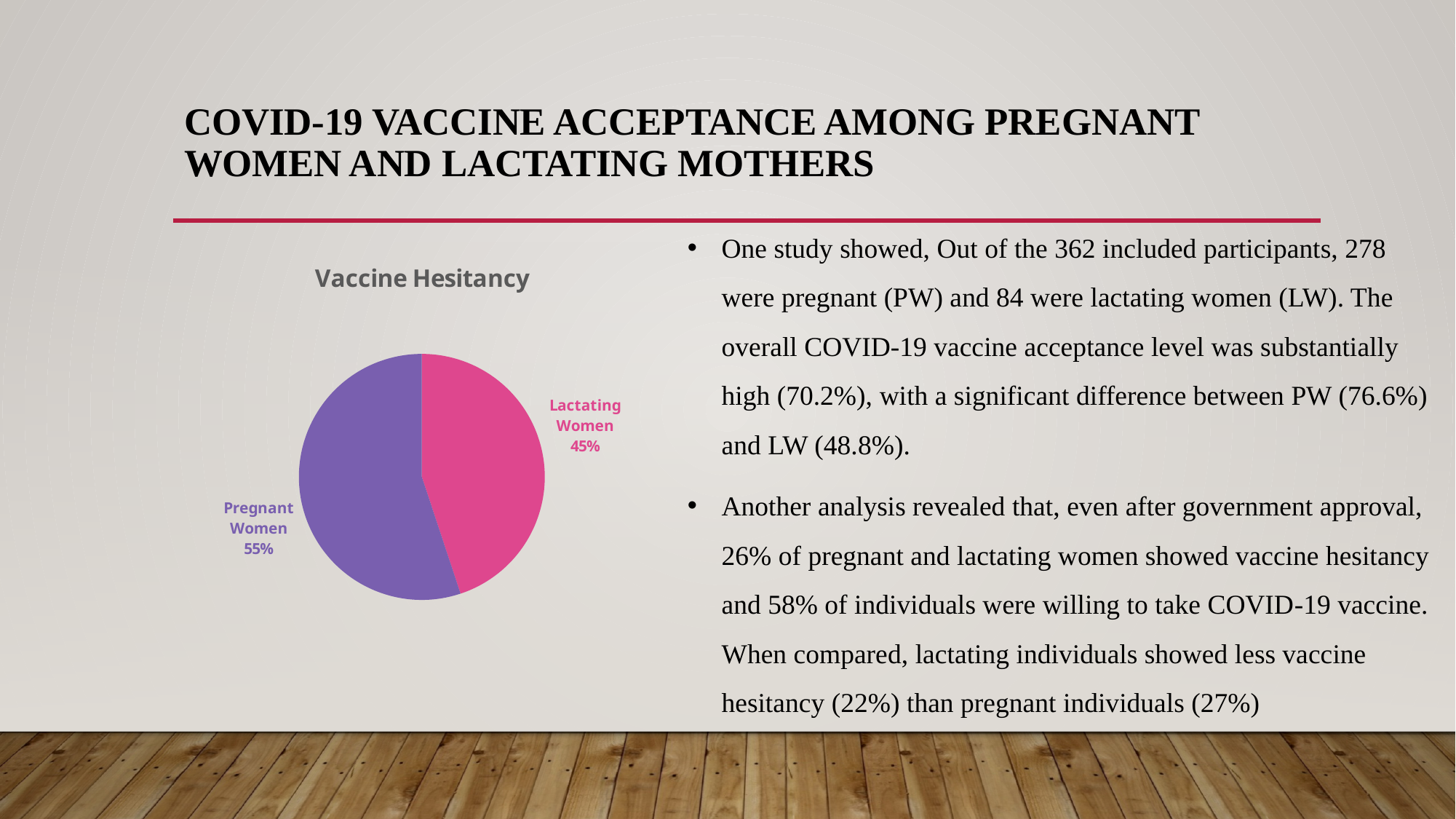
Which slice of the pie is the largest? Pregnant Women What colour is the Pregnant Women slice? purple What share of the pie is labelled Pregnant Women? 55% What kind of chart is shown on the slide? pie chart What is the title of the chart? Vaccine Hesitancy What share of the pie is labelled Lactating Women? 45% Which slice of the pie is the smallest? Lactating Women What is the difference in percentage points between the Pregnant Women slice and the Lactating Women slice? 10 Which is larger, the Pregnant Women slice or the Lactating Women slice? Pregnant Women How many slices does the pie chart have? 2 Is the share for Lactating Women greater or less than 50%? less